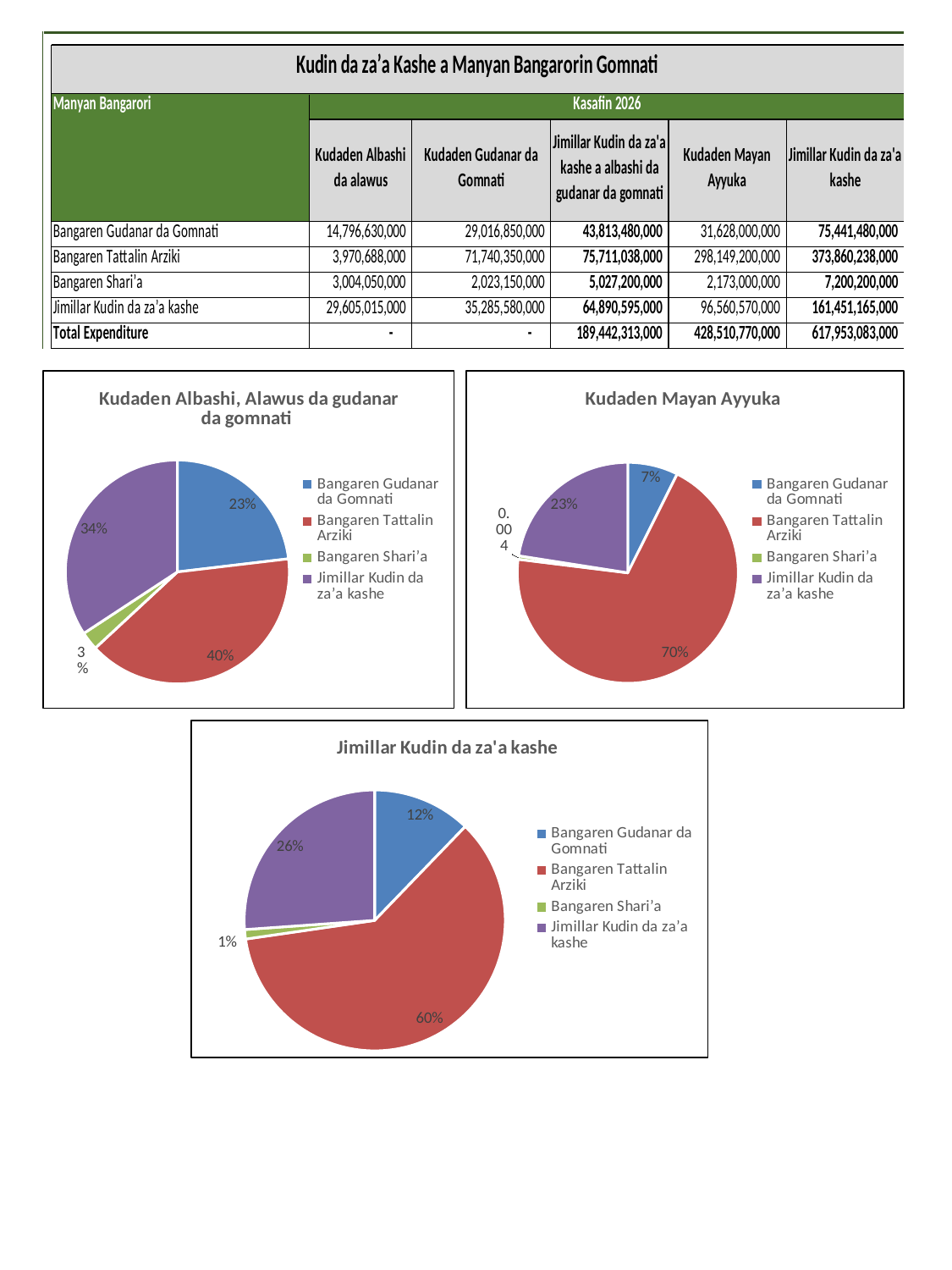
In the chart titled "Jimillar Kudin da za'a kashe", what is the difference between the Bangaren Tattalin Arziki share and the Bangaren Gudanar da Gomnati share? 48% In the chart titled "Kudaden Albashi, Alawus da gudanar da gomnati", what share of the pie is Jimillar Kudin da za'a kashe? 34% In the chart titled "Jimillar Kudin da za'a kashe", what share of the pie is Jimillar Kudin da za'a kashe? 26% In the chart titled "Kudaden Albashi, Alawus da gudanar da gomnati", which category has the smallest slice? Bangaren Shari'a In the chart titled "Kudaden Mayan Ayyuka", what share of the pie is Bangaren Gudanar da Gomnati? 7% In the chart titled "Kudaden Mayan Ayyuka", which category has the largest slice? Bangaren Tattalin Arziki How many categories does the legend of the chart titled "Kudaden Mayan Ayyuka" list? 4 In the chart titled "Jimillar Kudin da za'a kashe", which is larger: Bangaren Gudanar da Gomnati or Jimillar Kudin da za'a kashe? Jimillar Kudin da za'a kashe What kind of chart is the chart titled "Jimillar Kudin da za'a kashe"? Pie chart